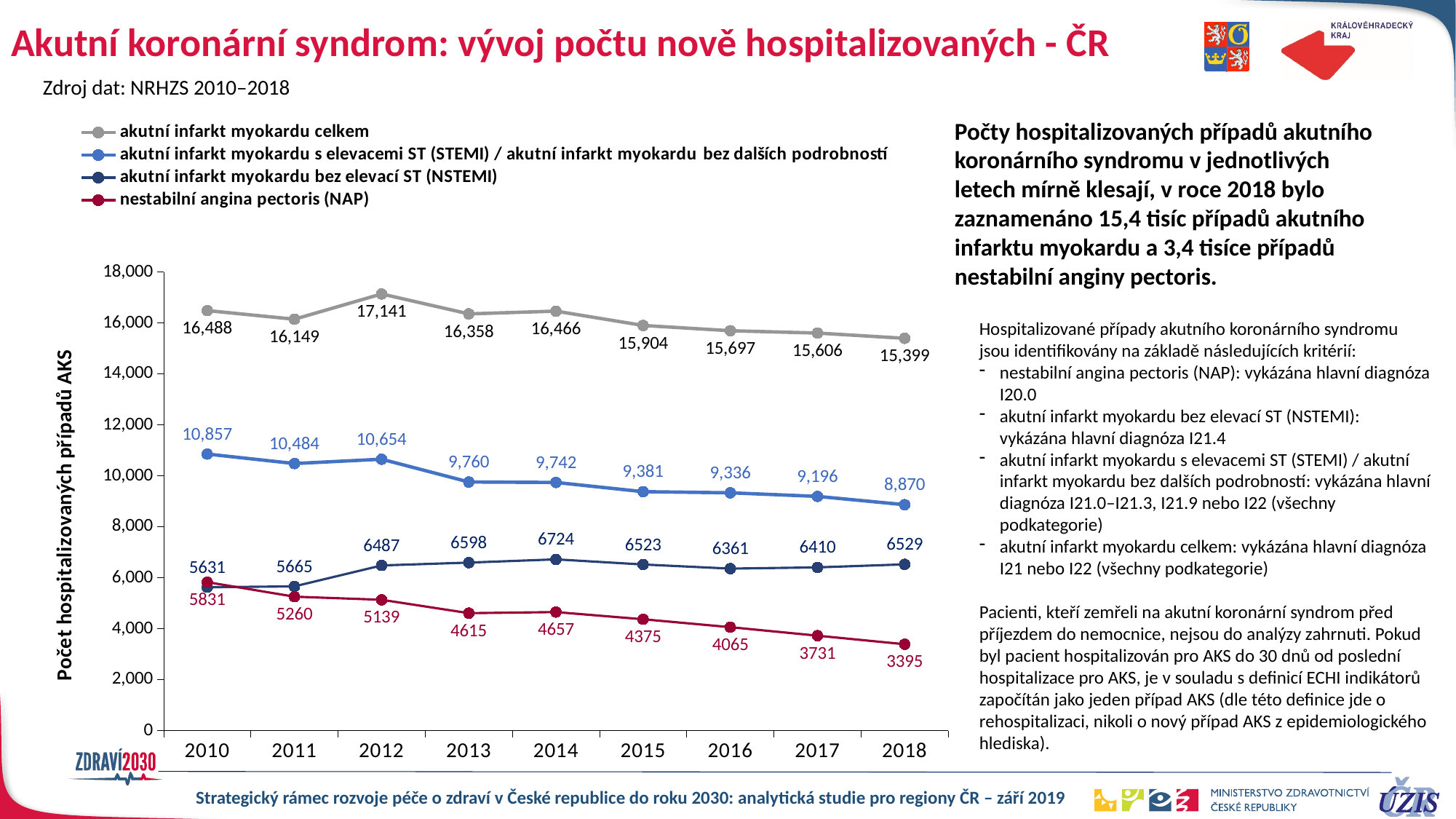
What is the value for akutní infarkt myokardu bez elevací ST (NSTEMI) in 2014? 6724 Which is larger in 2010: the NSTEMI value or the NAP value? NAP (5831) What is the value for akutní infarkt myokardu celkem in 2012? 17,141 How many years are shown on the x axis? 9 How many series does the legend list? 4 What is the difference between the akutní infarkt myokardu celkem values in 2010 and 2018? 1,089 What is the value for the STEMI series in 2010? 10,857 What kind of chart is shown on the slide? Line chart What is the value for nestabilní angina pectoris (NAP) in 2018? 3395 Does the nestabilní angina pectoris (NAP) series generally rise or fall from 2010 to 2018? Fall In which year is the value for akutní infarkt myokardu celkem highest? 2012 In which year is the value for nestabilní angina pectoris (NAP) lowest? 2018